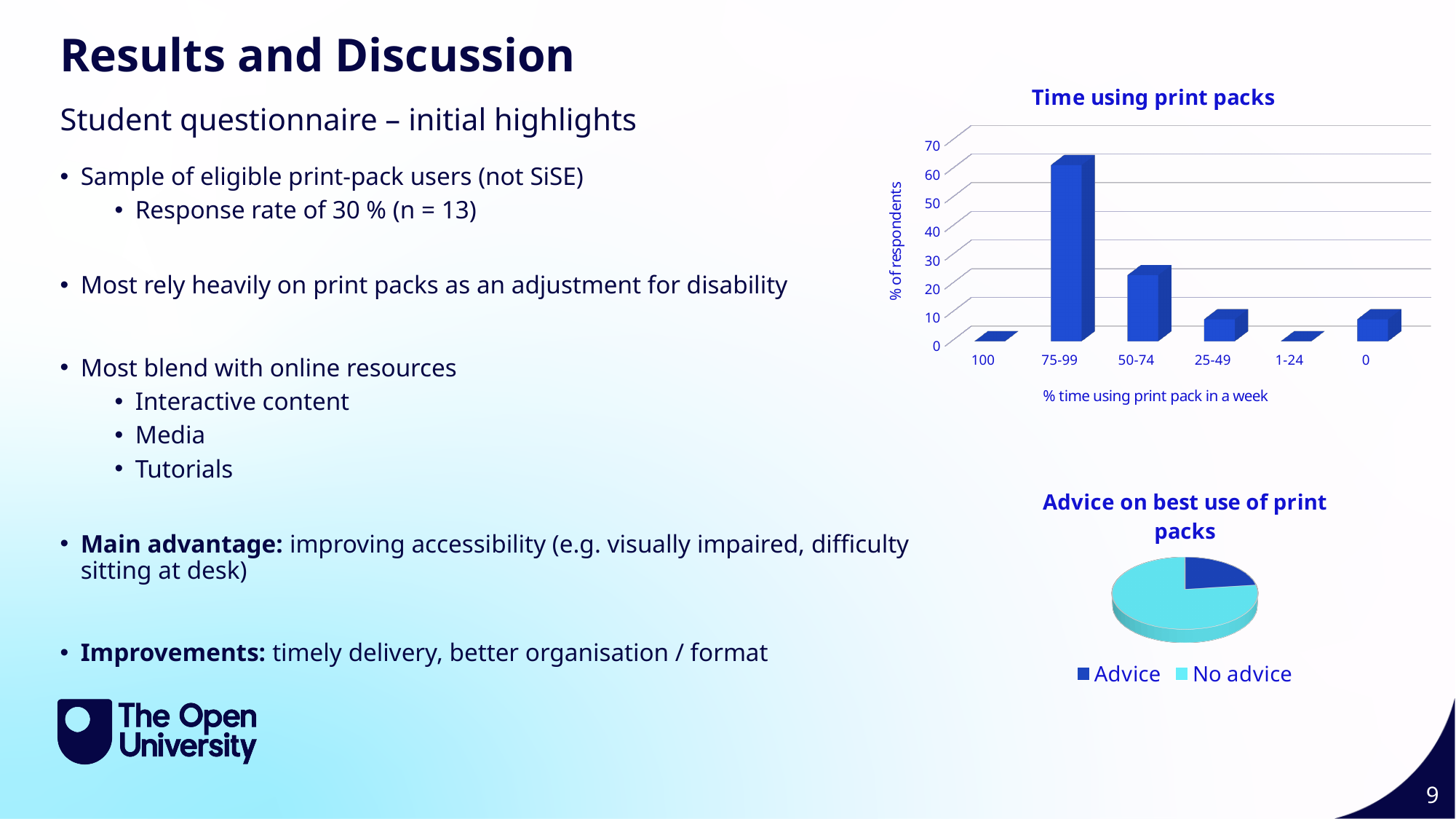
In the 'Time using print packs' chart, which is larger: the value for 50-74 or the value for 25-49? 50-74 In the 'Time using print packs' chart, is the value for 25-49 greater or less than 20? less In the 'Advice on best use of print packs' chart, which slice is larger: Advice or No advice? No advice In the 'Time using print packs' chart, which category has the highest value? 75-99 What is the label of the vertical axis on the 'Time using print packs' chart? % of respondents In the 'Time using print packs' chart, which is larger: the value for 75-99 or the value for 50-74? 75-99 How many categories are shown on the x axis of the 'Time using print packs' chart? 6 What kind of chart is the 'Time using print packs' chart? bar chart In the 'Time using print packs' chart, is the value for 75-99 greater or less than 50? greater What kind of chart is the 'Advice on best use of print packs' chart? pie chart In the 'Time using print packs' chart, is the value for 50-74 greater or less than 30? less How many entries does the legend of the 'Advice on best use of print packs' chart list? 2